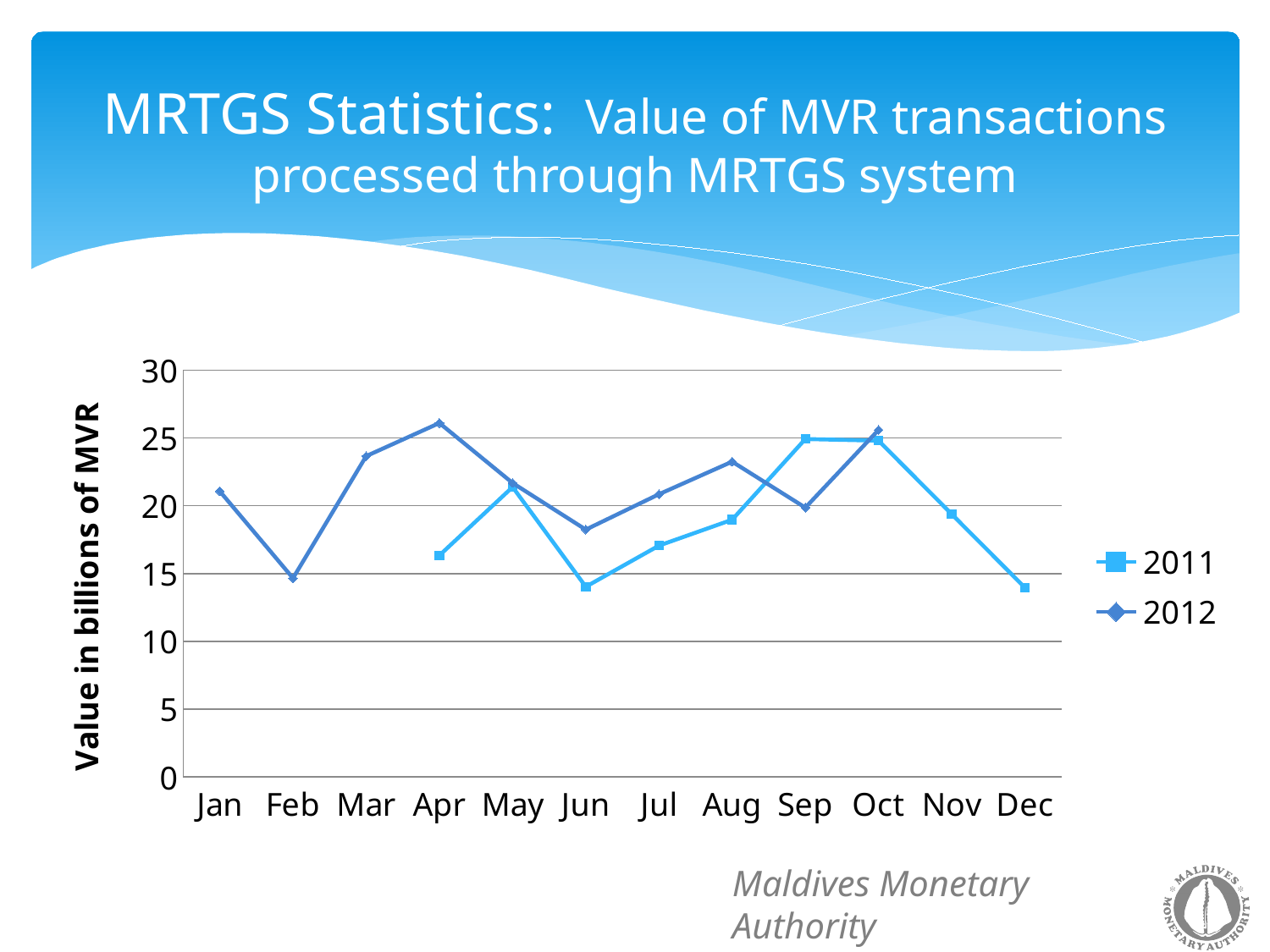
Which is larger in Jun, the 2011 value or the 2012 value? 2012 What kind of chart is shown on the slide? Line chart Is the 2012 value for Feb greater or less than 15? less How many months are shown on the x axis? 12 Is the 2011 value for Jun greater or less than 15? less In which month is the 2012 value lowest? Feb Is the 2012 value for Mar greater or less than 20? greater What is the label on the y axis? Value in billions of MVR Which is larger in Apr, the 2011 value or the 2012 value? 2012 Does the 2011 line rise or fall from Oct to Dec? fall How many series does the legend list? 2